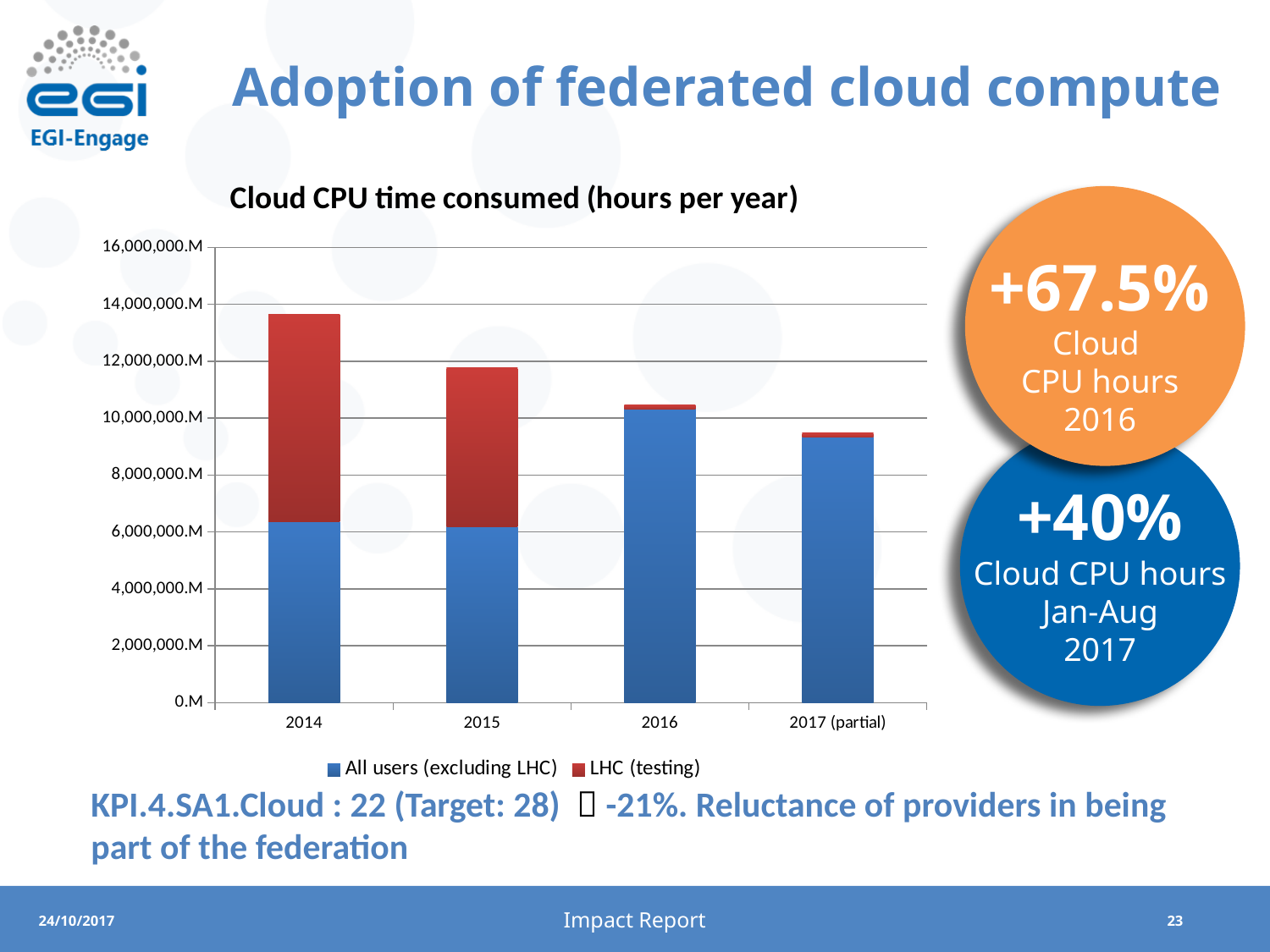
Which year has the highest value for LHC (testing)? 2014 Which category has the lowest total cloud CPU time consumed? 2017 (partial) Which year has the highest value for All users (excluding LHC)? 2016 Is the total cloud CPU time for 2014 greater or less than 12,000,000.M? greater Which series is shown in red in the chart? LHC (testing) Is the value for All users (excluding LHC) in 2015 greater or less than 8,000,000.M? less What kind of chart is shown on the slide? Stacked bar chart How many series does the chart legend list? 2 How many year categories are shown on the x axis of the chart? 4 Which year has the highest total cloud CPU time consumed? 2014 Do the total bar heights rise or fall from 2014 to 2017 (partial)? fall What is the title of the chart? Cloud CPU time consumed (hours per year)